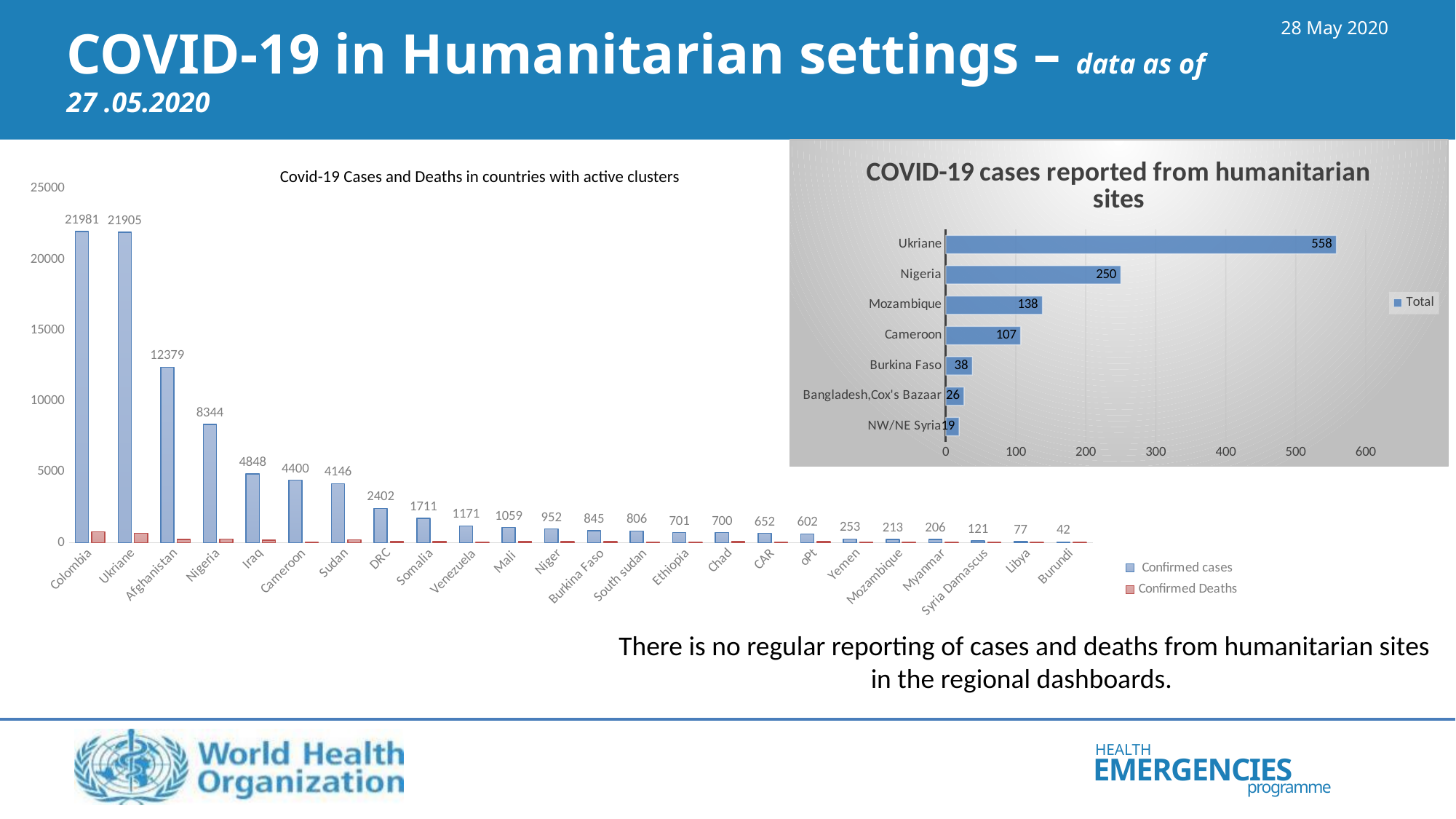
In the chart 'Covid-19 Cases and Deaths in countries with active clusters', how many series does the legend list? 2 In the chart 'Covid-19 Cases and Deaths in countries with active clusters', how many countries are shown on the x axis? 24 In the chart 'COVID-19 cases reported from humanitarian sites', what series name does the legend show? Total In the chart 'Covid-19 Cases and Deaths in countries with active clusters', how many confirmed cases are shown for Afghanistan? 12379 In the chart 'COVID-19 cases reported from humanitarian sites', which site has the lowest number of cases? NW/NE Syria In the chart 'Covid-19 Cases and Deaths in countries with active clusters', what is the difference in confirmed cases between Colombia and Ukraine? 76 In the chart 'COVID-19 cases reported from humanitarian sites', which site has the highest number of cases? Ukriane In the chart 'COVID-19 cases reported from humanitarian sites', what is the difference between the cases for Mozambique and Cameroon? 31 In the chart 'Covid-19 Cases and Deaths in countries with active clusters', which country has the highest number of confirmed cases? Colombia In the chart 'COVID-19 cases reported from humanitarian sites', how many sites are listed? 7 In the chart 'COVID-19 cases reported from humanitarian sites', how many cases are reported for Nigeria? 250 In the chart 'Covid-19 Cases and Deaths in countries with active clusters', which has more confirmed cases, Iraq or Sudan? Iraq